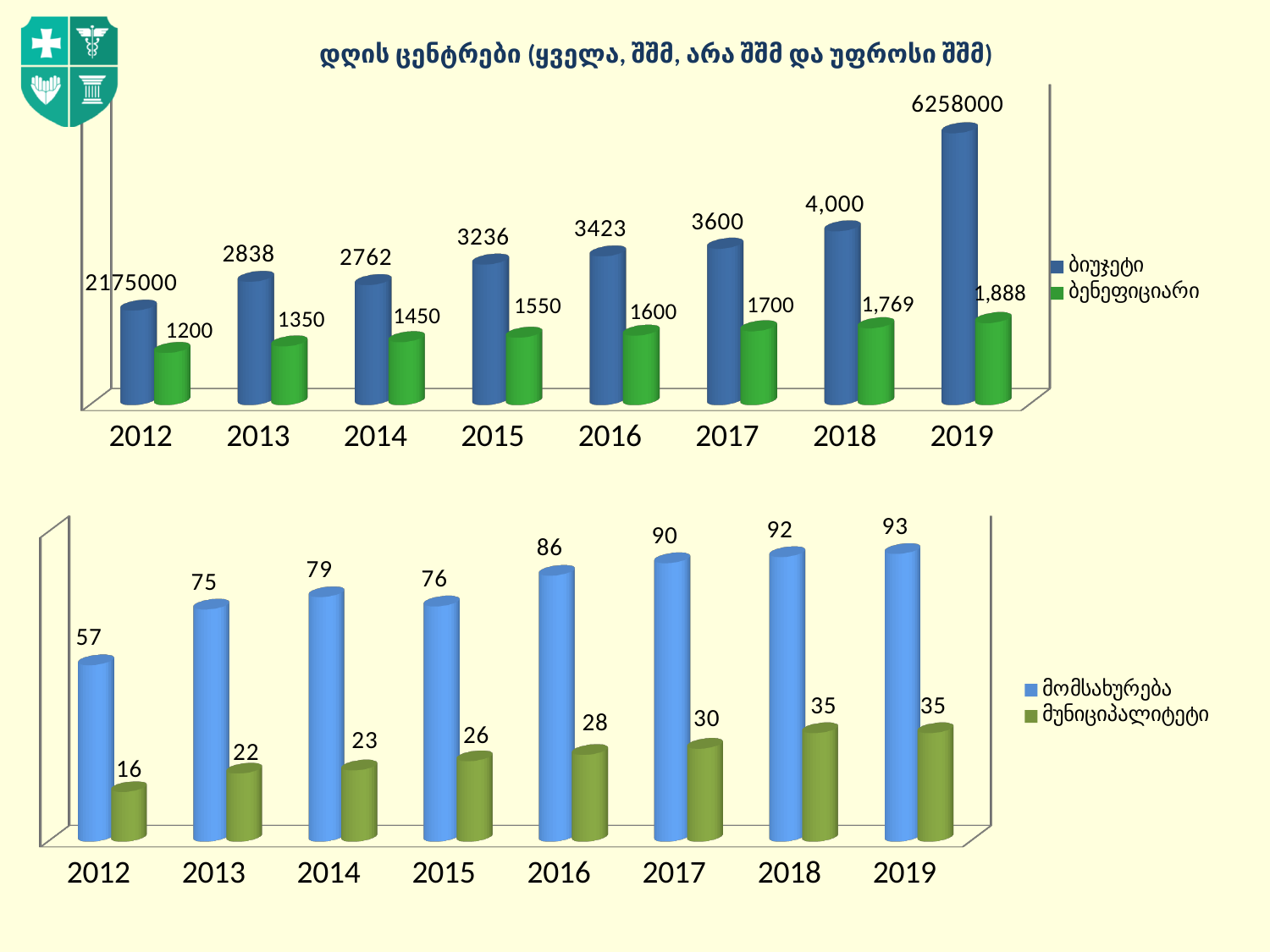
In the top chart, which year has the highest ბენეფიციარი value? 2019 In the bottom chart, what is the difference between the მომსახურება values for 2019 and 2012? 36 In the bottom chart, what is the value of მომსახურება for 2016? 86 In the top chart, what is the difference between the ბენეფიციარი values for 2017 and 2016? 100 In the top chart, how many series does the legend list? 2 In the top chart, do the ბენეფიციარი values rise or fall from 2012 to 2019? rise In the top chart, what is the value of ბიუჯეტი for 2019? 6258000 How many years are shown on the x axis of the bottom chart? 8 In the bottom chart, which year has the lowest მუნიციპალიტეტი value? 2012 What type of chart is the bottom chart? bar chart In the bottom chart, which is larger: მომსახურება for 2014 or მომსახურება for 2015? 2014 In the top chart, what is the value of ბენეფიციარი for 2018? 1,769